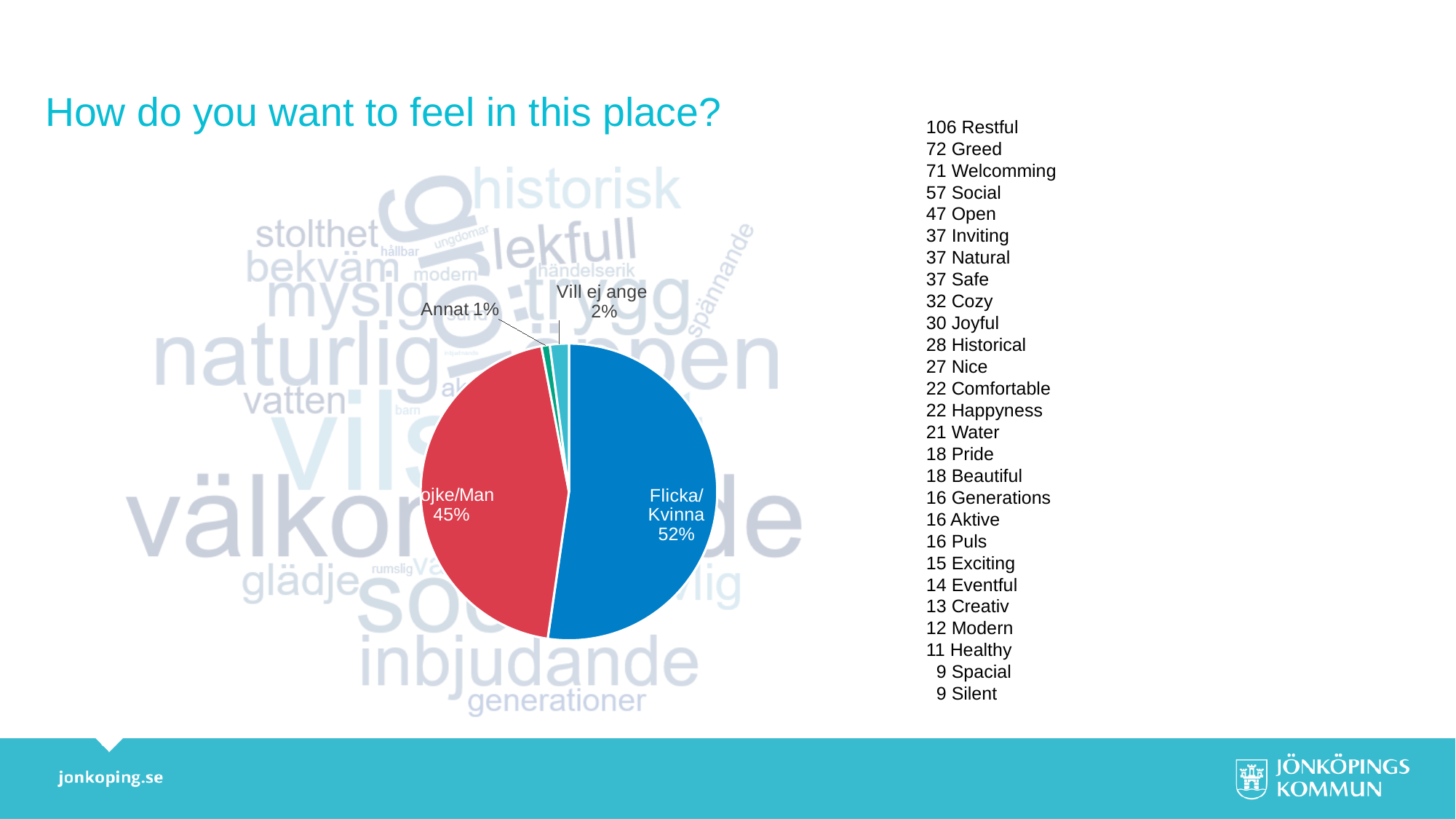
What colour is the Flicka/Kvinna slice in the pie chart? blue What is the difference in percentage points between the Flicka/Kvinna and Pojke/Man slices? 7 What share of the pie does the Flicka/Kvinna slice represent? 52% How many slices does the pie chart have? 4 Which slice of the pie chart is the largest? Flicka/Kvinna What share of the pie does the Vill ej ange slice represent? 2% What kind of chart is shown on the slide? pie chart What share of the pie does the Pojke/Man slice represent? 45% Which slice of the pie chart is the smallest? Annat Which is larger, the Vill ej ange slice or the Annat slice? Vill ej ange Which is larger, the Pojke/Man slice or the Flicka/Kvinna slice? Flicka/Kvinna